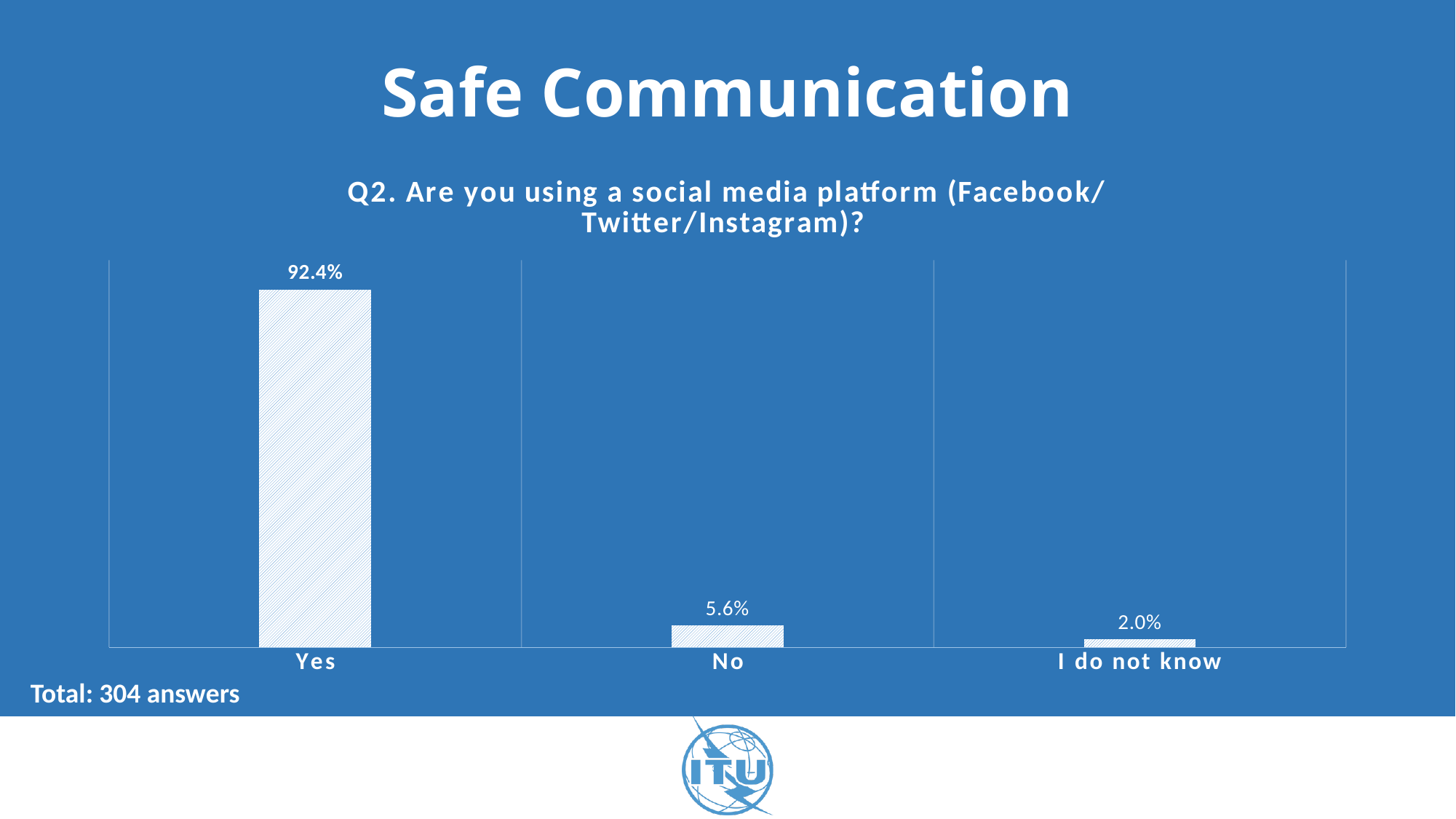
What is the title of the chart? Q2. Are you using a social media platform (Facebook/Twitter/Instagram)? What is the difference in percentage points between "No" and "I do not know"? 3.6 Which answer category has the highest percentage? Yes Which is larger, the value for "No" or the value for "I do not know"? No Do the values rise or fall from left to right across the categories? Fall What kind of chart is shown on the slide? Bar chart What percentage of respondents answered "No"? 5.6% Which answer category has the lowest percentage? I do not know What percentage of respondents answered "I do not know"? 2.0% What percentage of respondents answered "Yes"? 92.4% What is the difference in percentage points between "Yes" and "No"? 86.8 How many answer categories are shown on the chart? 3